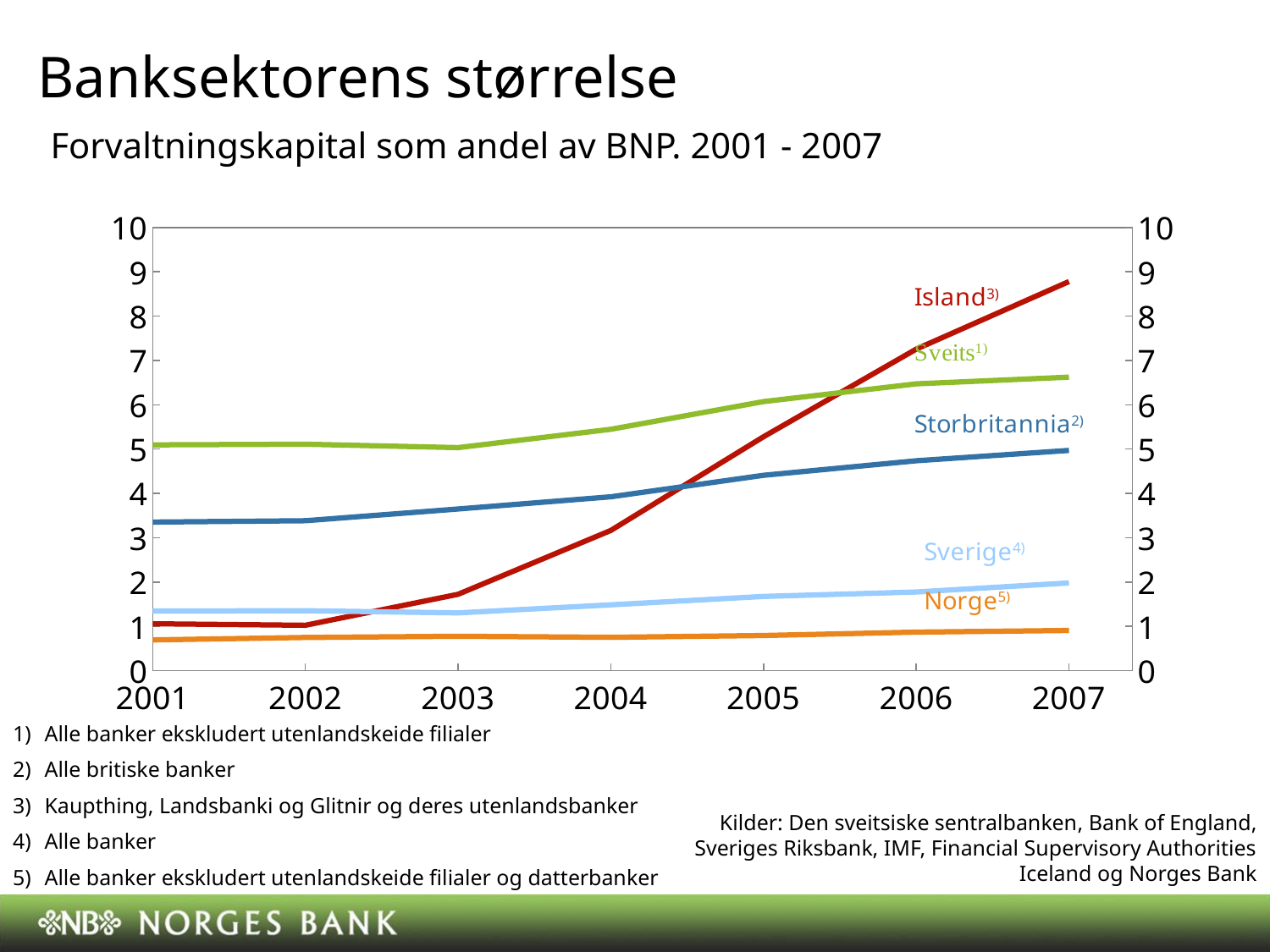
What is the subtitle of the chart? Forvaltningskapital som andel av BNP. 2001 - 2007 Is the value for Island in 2007 greater or less than 8? greater What kind of chart is shown on the slide? line chart Is the value for Norge in 2007 greater or less than 2? less Is the value for Storbritannia in 2001 greater or less than 4? less Does the value for Island rise or fall from 2001 to 2007? rise Which country has the lowest value in 2007? Norge How many country series are plotted in the chart? 5 In 2003, which is larger: the value for Sveits or the value for Island? Sveits Which country has the highest value in 2001? Sveits How many years are shown on the x axis of the chart? 7 Which country has the highest value in 2007? Island